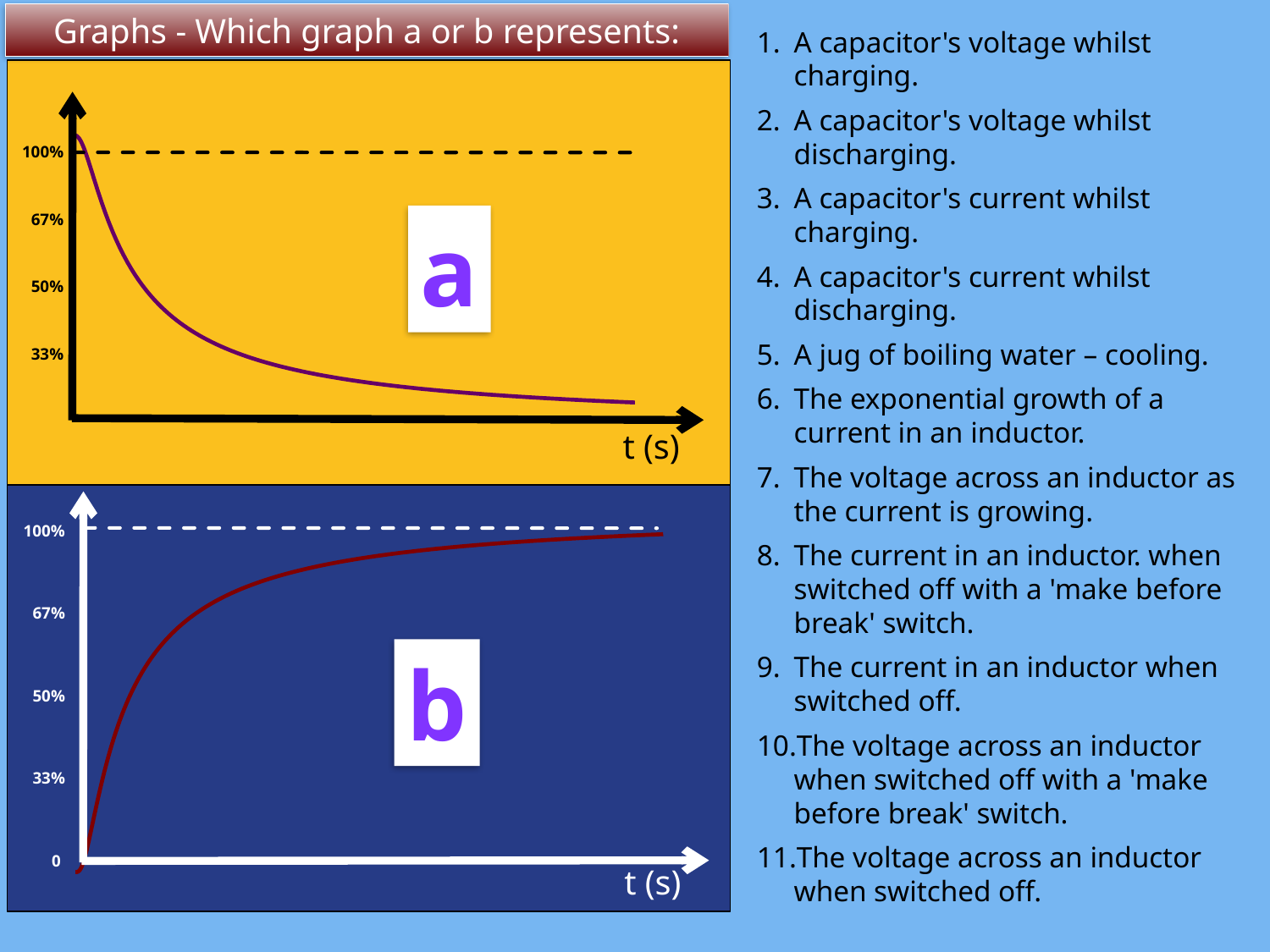
What is the label on the x axis of graph a? t (s) In graph b, what value is printed at the origin of the y axis? 0 What kind of chart is graph a? line chart In graph a, is the value at the right-hand end of the curve greater or less than 33%? less What kind of chart is graph b? line chart In graph b, is the value at the start of the curve greater or less than 33%? less In graph a, at what percentage level is the horizontal dashed line drawn? 100% In graph a, is the value at the start of the curve greater or less than 67%? greater What is the title of the slide containing the two graphs? Graphs - Which graph a or b represents: In graph a, does the plotted value rise or fall as time increases? fall In graph b, does the plotted value rise or fall as time increases? rise